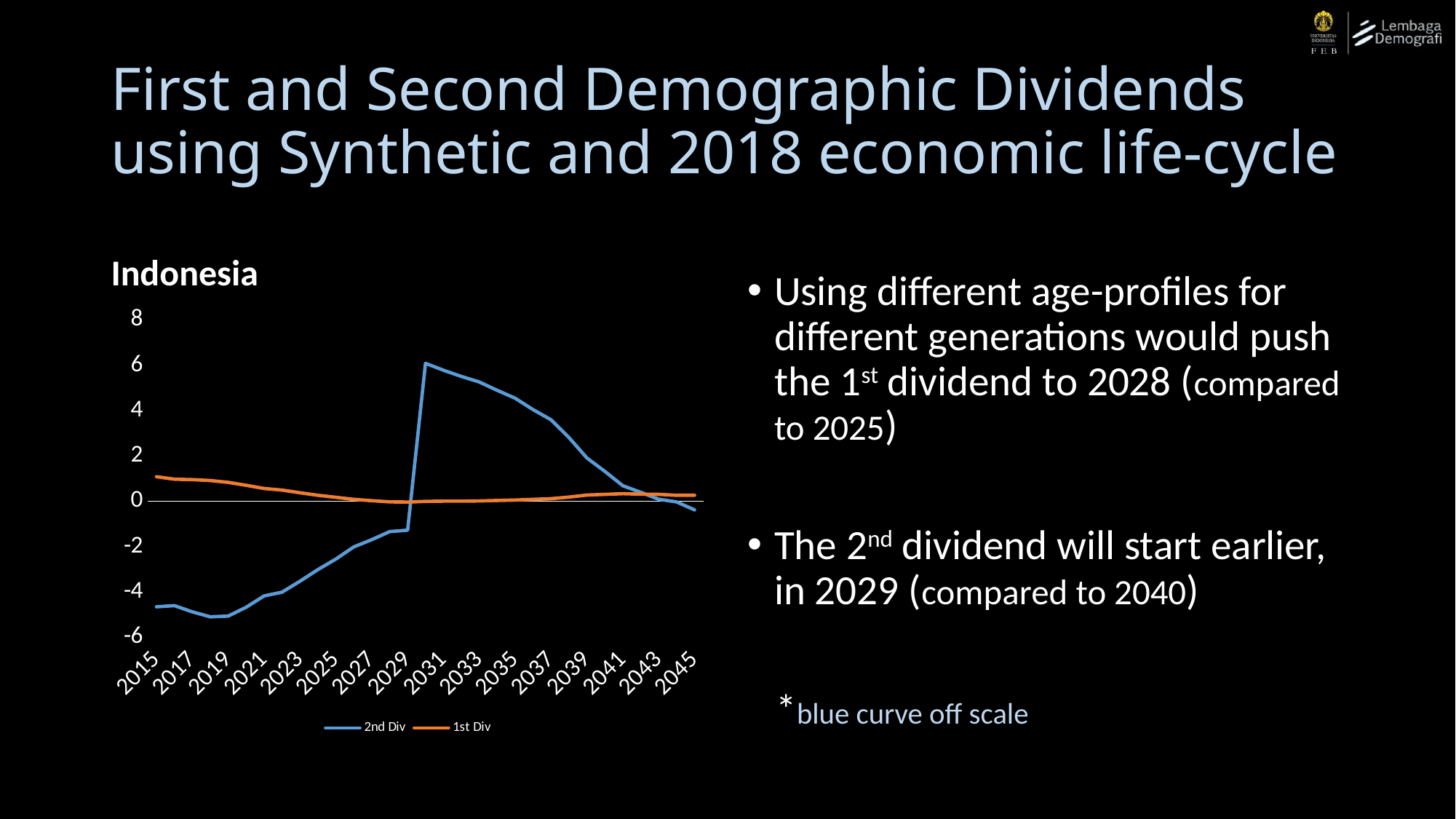
How many series does the chart's legend list? 2 What is the title of the chart? Indonesia Is the value for 1st Div in 2015 greater or less than 2? less Which series is drawn in orange? 1st Div How many year labels are shown on the x axis? 16 Is the value for 2nd Div in 2031 greater or less than 4? greater In 2035, which series has the higher value, 2nd Div or 1st Div? 2nd Div Is the value for 2nd Div in 2037 greater or less than 2? greater Does the 2nd Div line rise or fall between 2031 and 2045? fall In 2015, which series has the higher value, 2nd Div or 1st Div? 1st Div What kind of chart is shown on the slide? line chart